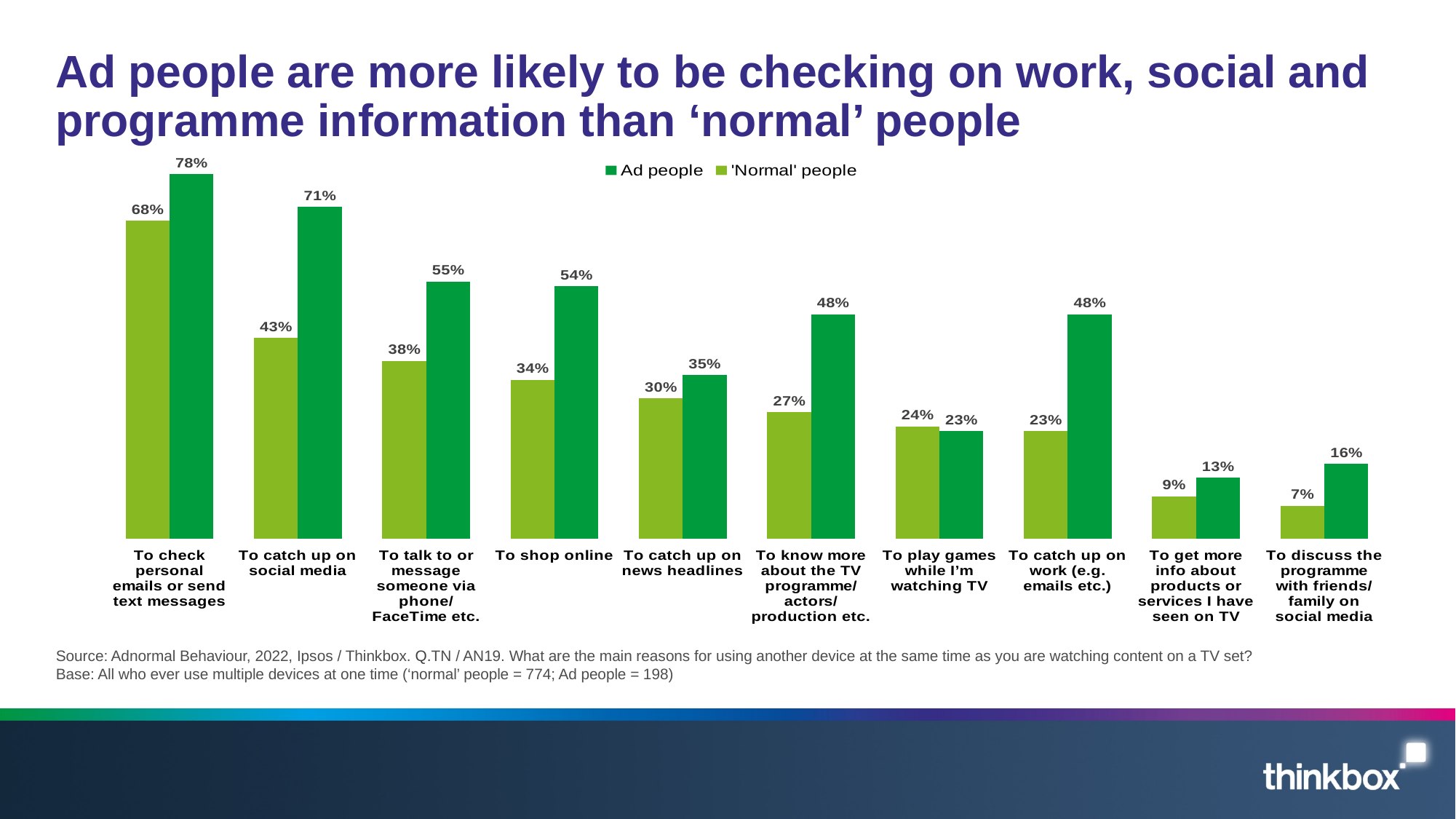
Which is larger for 'To play games while I'm watching TV': Ad people or 'Normal' people? 'Normal' people What is the difference between Ad people and 'Normal' people for 'To catch up on work (e.g. emails etc.)'? 25 percentage points How many categories are shown on the x axis? 10 Which category has the highest value for Ad people? To check personal emails or send text messages What is the value for 'Normal' people for 'To catch up on work (e.g. emails etc.)'? 23% Which category has the lowest value for 'Normal' people? To discuss the programme with friends/ family on social media What kind of chart is shown on the slide? Bar chart What is the difference between Ad people and 'Normal' people for 'To catch up on social media'? 28 percentage points What is the value for Ad people for 'To check personal emails or send text messages'? 78% How many series does the legend list? 2 Which series is shown in dark green in the legend? Ad people What is the value for 'Normal' people for 'To shop online'? 34%